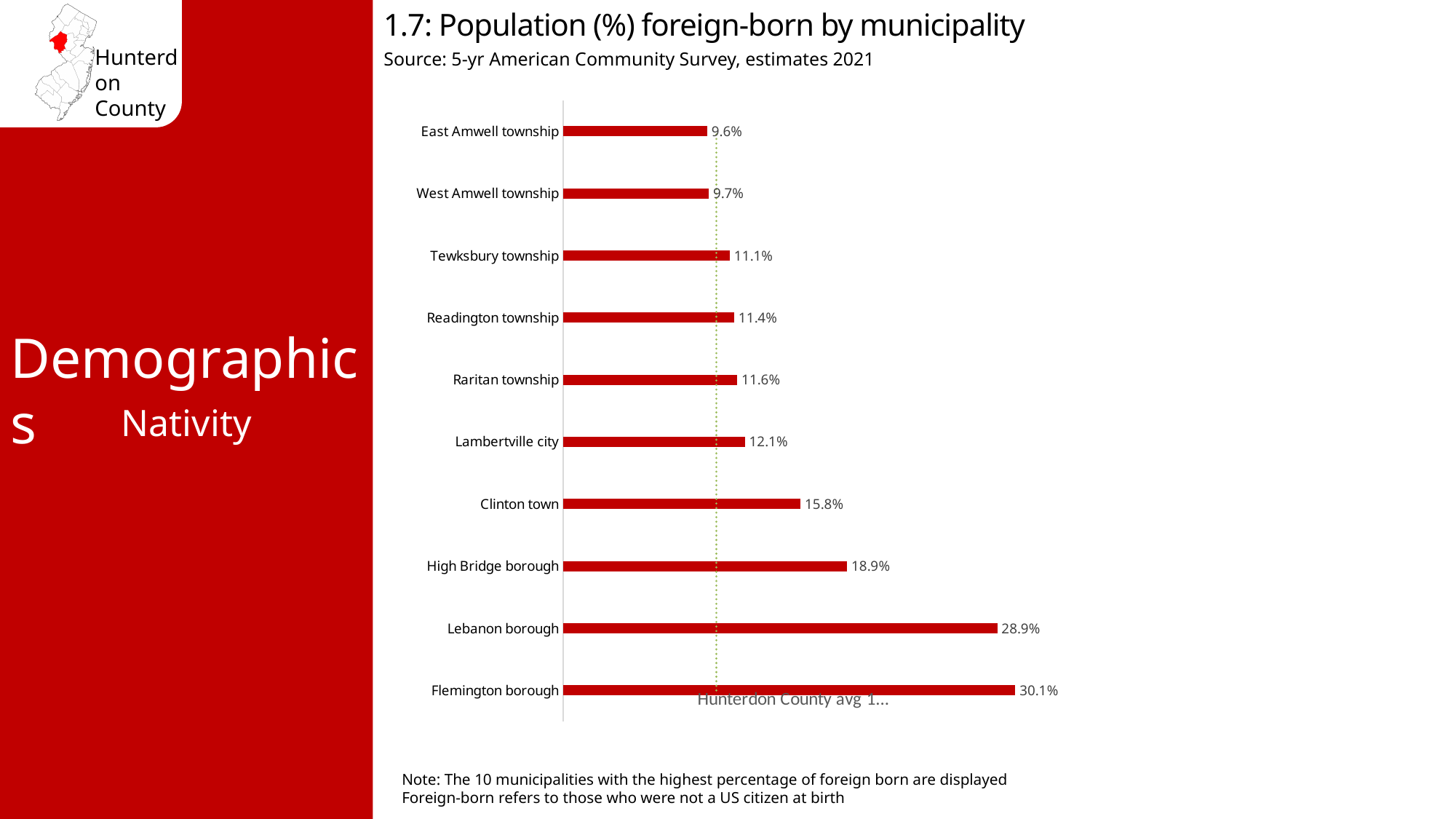
What is the difference in foreign-born percentage between Flemington borough and East Amwell township? 20.5% How many municipalities are shown on the chart? 10 What is the foreign-born population percentage for Lambertville city? 12.1% Which municipality has the highest percentage of foreign-born population? Flemington borough What is the source of the data shown in the chart? 5-yr American Community Survey, estimates 2021 What type of chart is used to show the foreign-born population by municipality? Bar chart What is the foreign-born population percentage for Flemington borough? 30.1% Which has a higher foreign-born percentage, Raritan township or Tewksbury township? Raritan township What is the difference in foreign-born percentage between Lebanon borough and Clinton town? 13.1% Which municipality has the lowest percentage of foreign-born population shown on the chart? East Amwell township What is the title of the chart? 1.7: Population (%) foreign-born by municipality What is the foreign-born population percentage for High Bridge borough? 18.9%